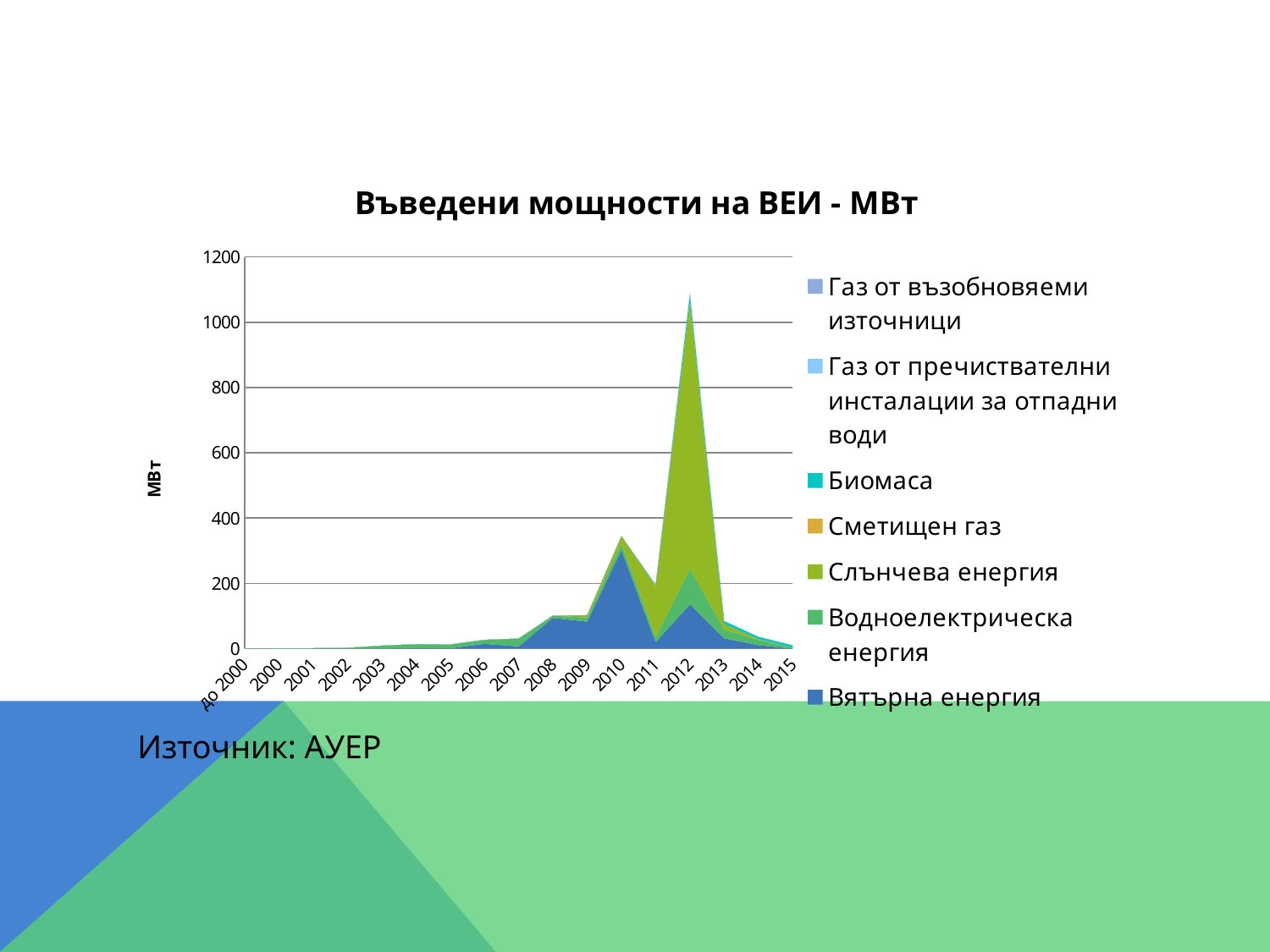
Which series accounts for most of the total in 2012? Слънчева енергия Which year has the larger total value, 2010 or 2012? 2012 Is the total value for 2012 greater or less than 1000? greater In which year does the total introduced capacity reach its highest value? 2012 Is the total value for 2010 greater or less than 200? greater How many series does the legend list? 7 How many categories are shown along the x axis? 17 What is the label on the vertical axis? МВт What is the title of the chart? Въведени мощности на ВЕИ - МВт Is the total value for 2013 greater or less than 200? less What kind of chart is shown on the slide? Area chart